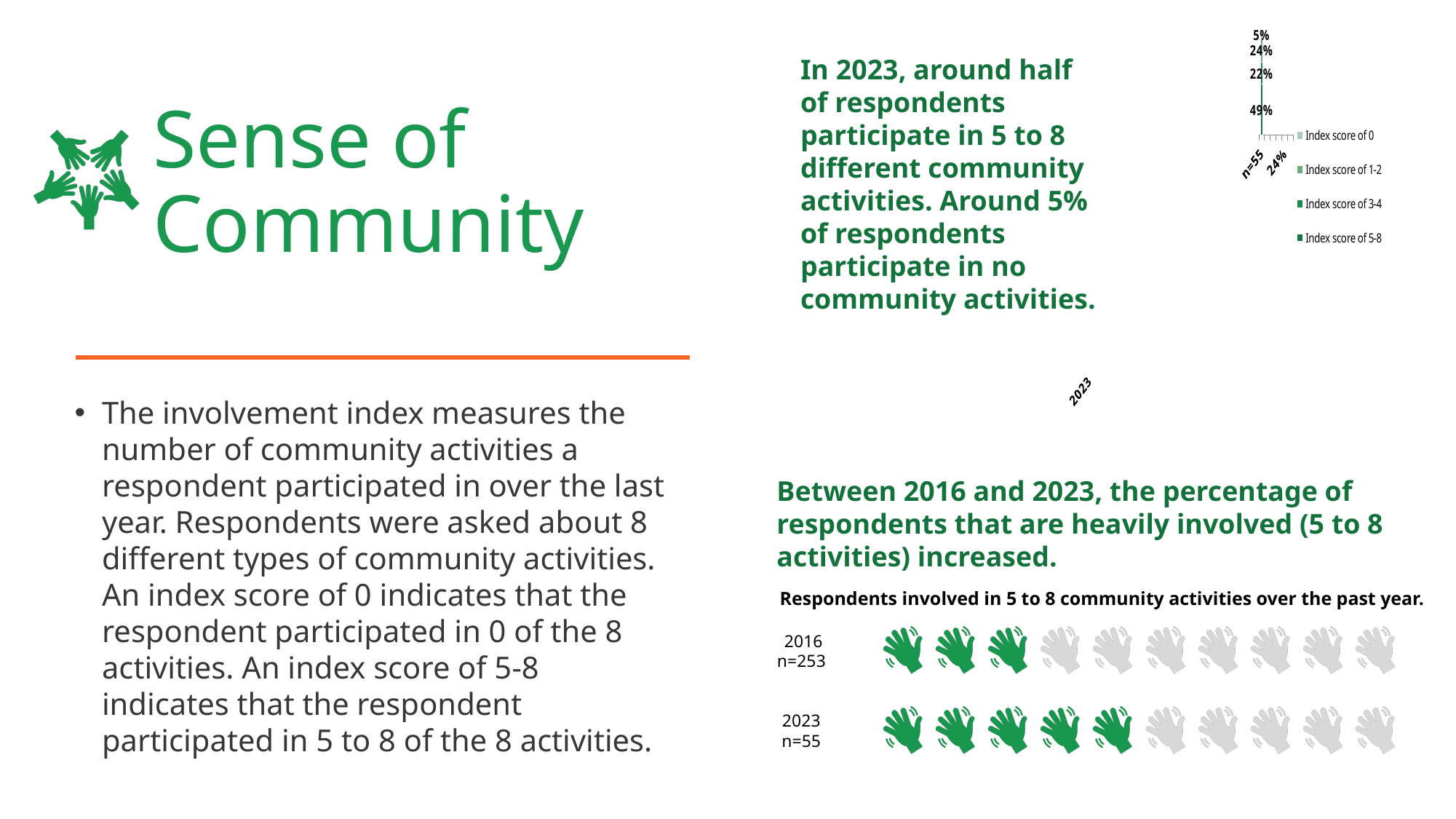
In the hand pictogram chart at the bottom right, how many hands are coloured green for 2016? 3 In the stacked bar chart at the top right, what is the smallest percentage labelled on the bar? 5% In the stacked bar chart at the top right, what is the largest percentage labelled on the bar? 49% In the hand pictogram chart at the bottom right, how many hands are coloured green for 2023? 5 In the stacked bar chart at the top right, what percentage of respondents have an index score of 5-8? 49% In the stacked bar chart at the top right, what sample size (n) is shown for 2023? n=55 In the stacked bar chart at the top right, what is the difference between the largest segment (49%) and the smallest segment (5%)? 44% In the stacked bar chart at the top right, what percentage of respondents have an index score of 0? 5% What kind of chart is the small chart at the top right of the slide? Stacked bar chart In the stacked bar chart at the top right, what is the total of the four labelled segments (5%, 24%, 22%, 49%)? 100% In the hand pictogram chart at the bottom right, which year has the larger share of respondents involved in 5 to 8 community activities, 2016 or 2023? 2023 In the stacked bar chart at the top right, how many entries does the legend list? 4